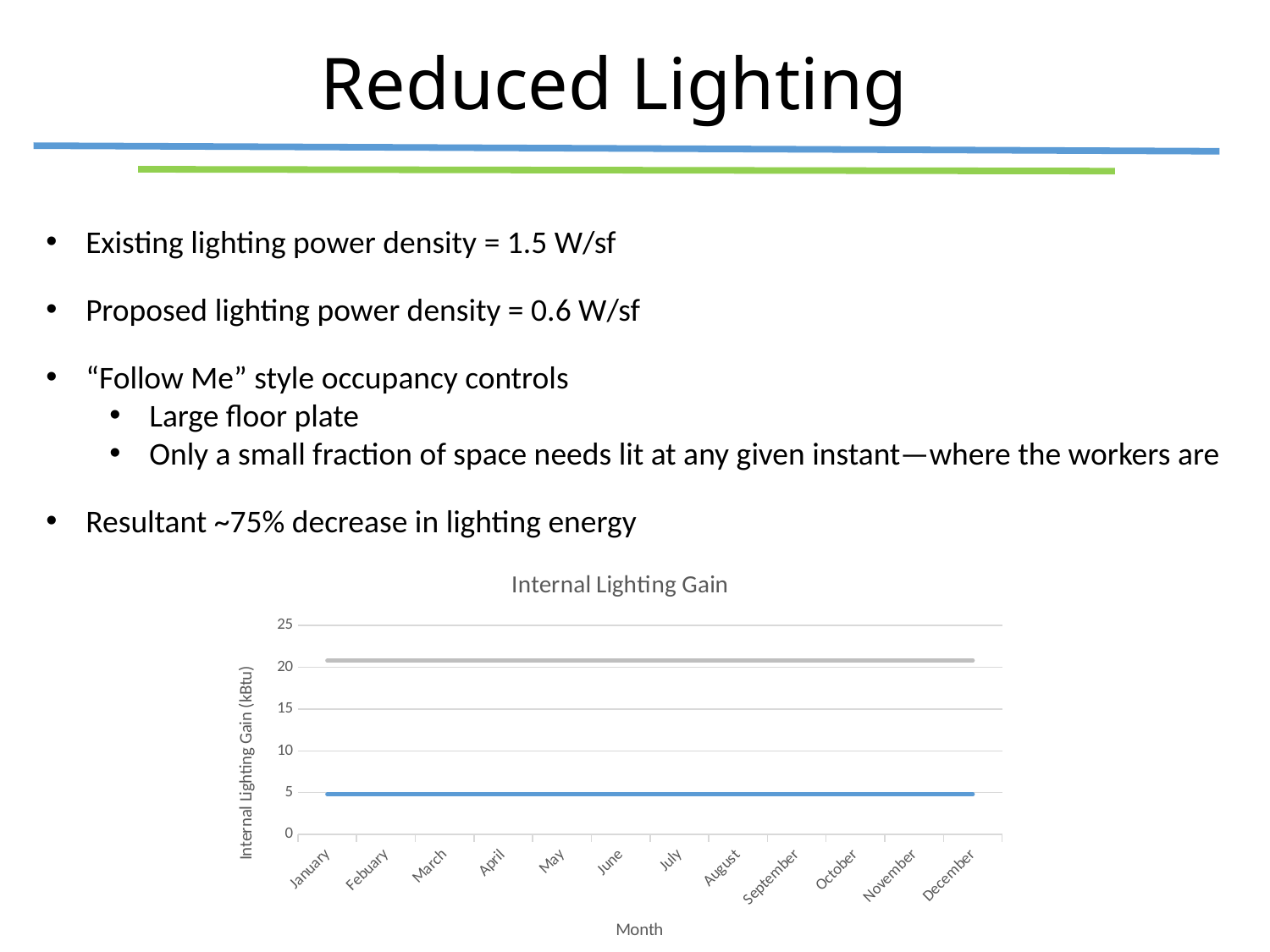
Which line has the higher values across the months, the gray line or the blue line? the gray line Do the values of the gray line rise, fall, or stay flat from January to December? stay flat Do the values of the blue line rise, fall, or stay flat from January to December? stay flat What is the highest value shown on the vertical axis of the chart? 25 How many months are shown along the x axis of the chart? 12 Is the value of the lower (blue) line in March greater or less than 10? less What is the title of the chart? Internal Lighting Gain Is the value of the upper (gray) line in June greater or less than 15? greater Is the value of the upper (gray) line in October greater or less than 25? less How many lines are plotted on the chart? 2 What kind of chart is shown on the slide? line chart What is the label of the vertical axis of the chart? Internal Lighting Gain (kBtu)